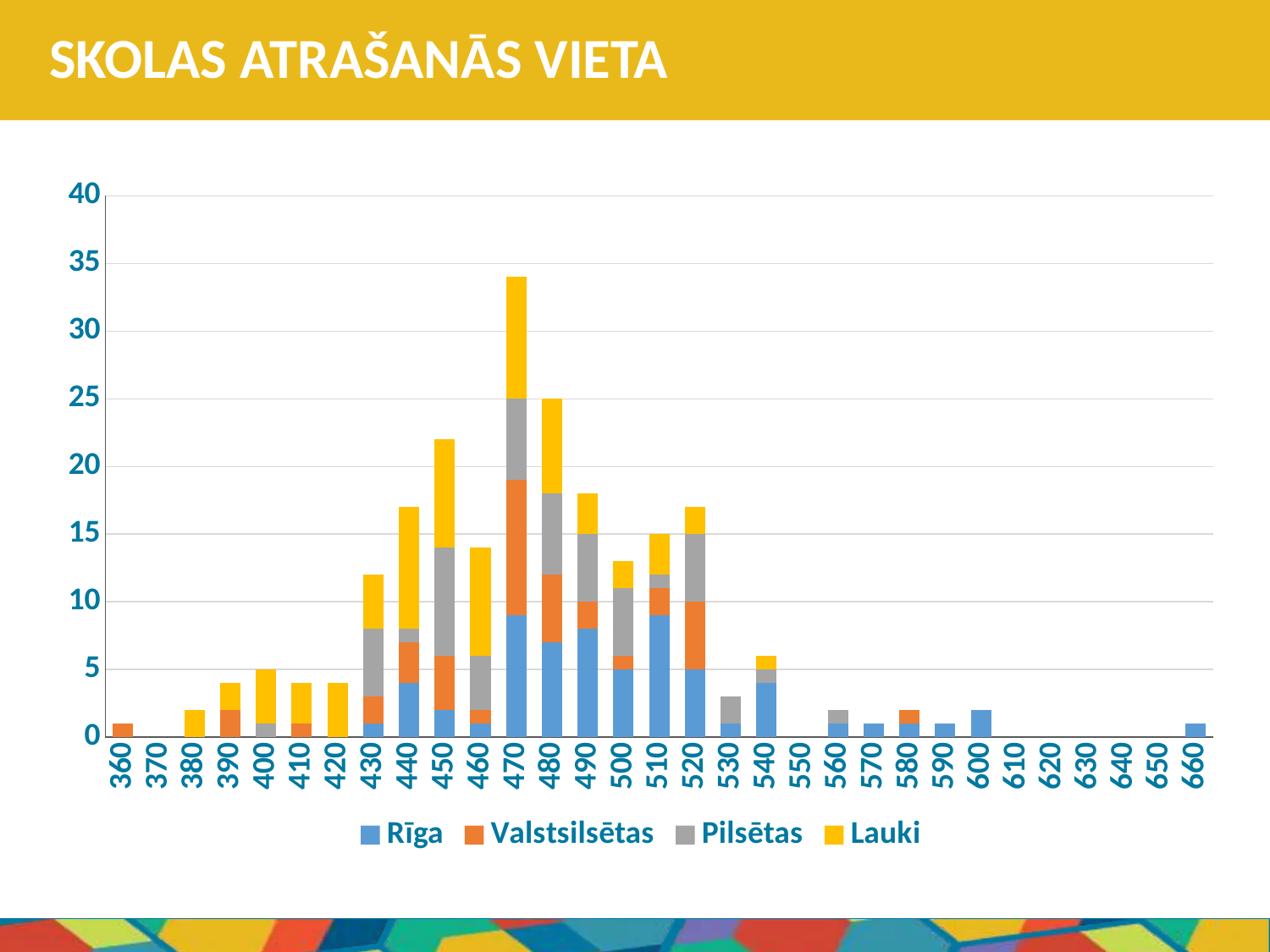
Which bar is taller, the one for 450 or the one for 460? 450 Which bar is taller, the one for 470 or the one for 480? 470 Is the total value of the bar for 530 greater or less than 5? less Is the total value of the bar for 470 greater or less than 30? greater How many series does the legend list? 4 Is the total value of the bar for 430 greater or less than 10? greater How many categories are shown along the x axis? 31 Which category has the tallest stacked bar? 470 Which series is shown in yellow in the legend? Lauki What is the title of the slide? SKOLAS ATRAŠANĀS VIETA What kind of chart is shown on the slide? stacked bar chart